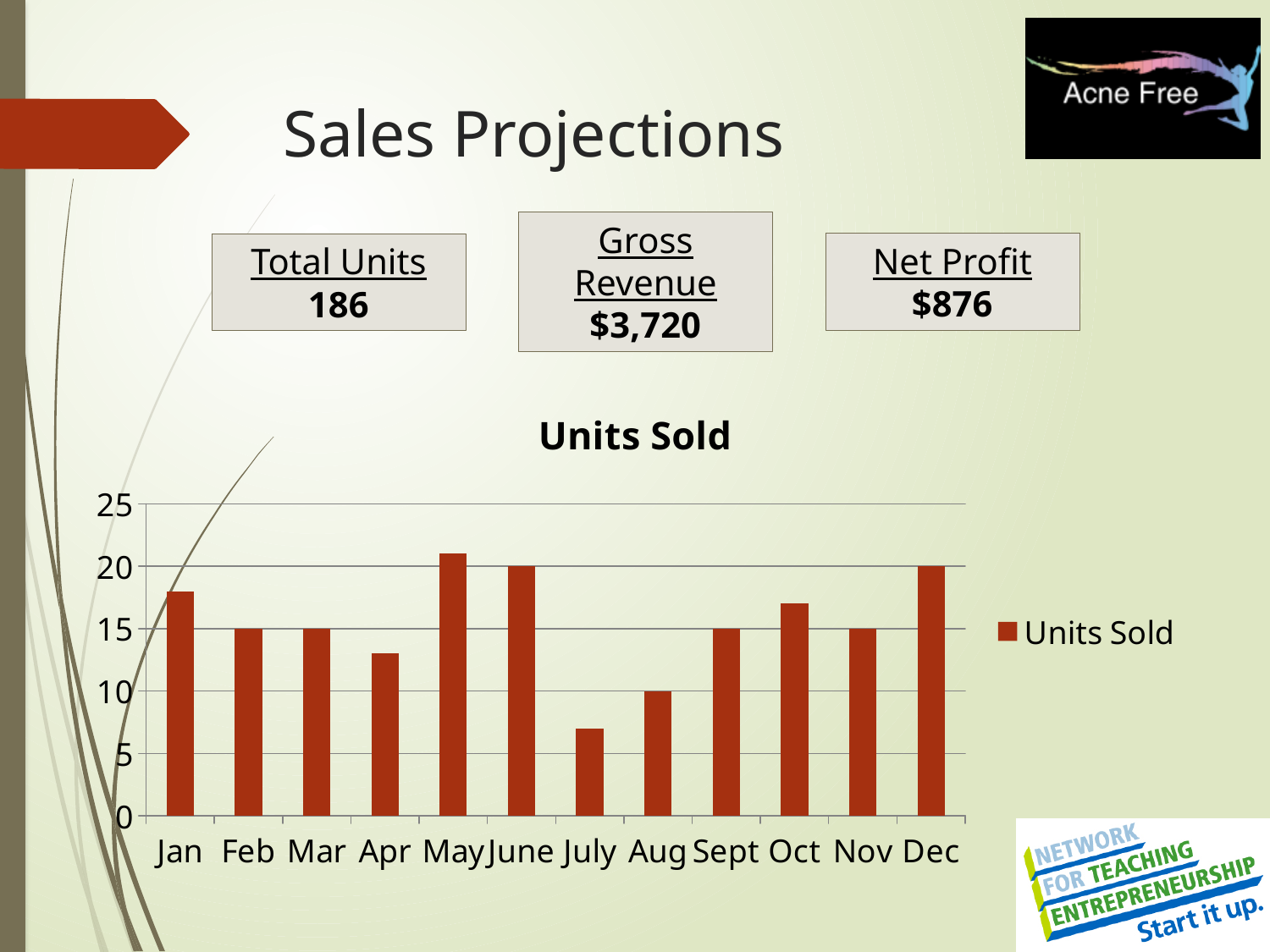
What is the value for Units Sold in Aug? 10 Which month has the highest units sold? May What type of chart is shown on the slide? bar chart Which month has more units sold, Apr or Oct? Oct What is the value for Units Sold in June? 20 What is the value for Units Sold in Feb? 15 How many series does the chart legend list? 1 What is the title of the chart? Units Sold Is the value for Units Sold in Jan greater or less than 15? greater Which month has the lowest units sold? July How many months are shown on the x axis of the chart? 12 Is the value for Units Sold in July greater or less than 10? less